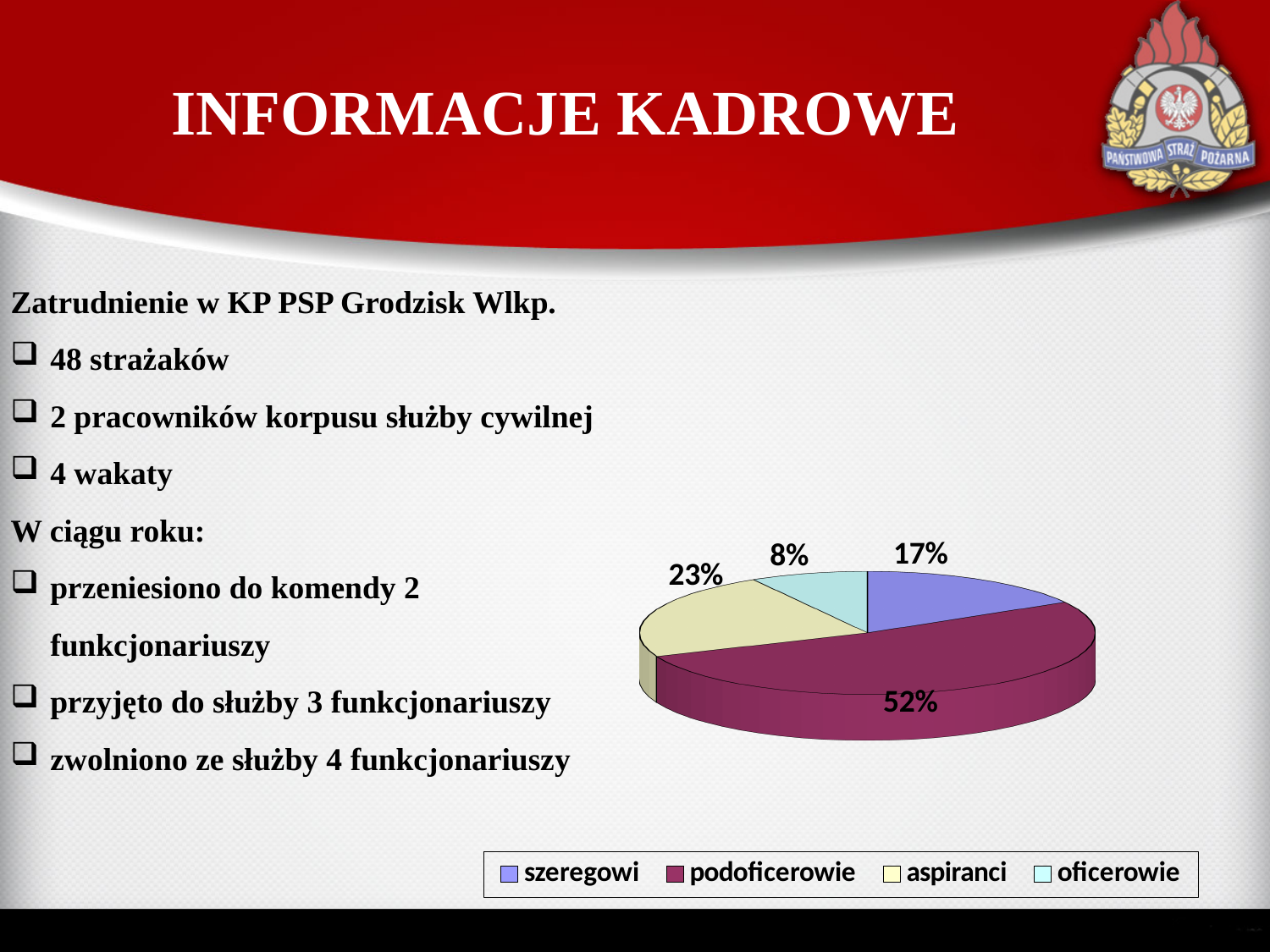
What colour is the slice for podoficerowie? magenta What share of the pie does aspiranci have? 23% How many categories does the pie chart show? 4 What kind of chart is shown on the slide? pie chart What is the difference in percentage points between podoficerowie and aspiranci? 29 What share of the pie does podoficerowie have? 52% Which is larger, the share for szeregowi or the share for aspiranci? aspiranci Which category has the largest slice of the pie? podoficerowie Which category has the smallest slice of the pie? oficerowie What share of the pie does oficerowie have? 8% How many entries does the legend list? 4